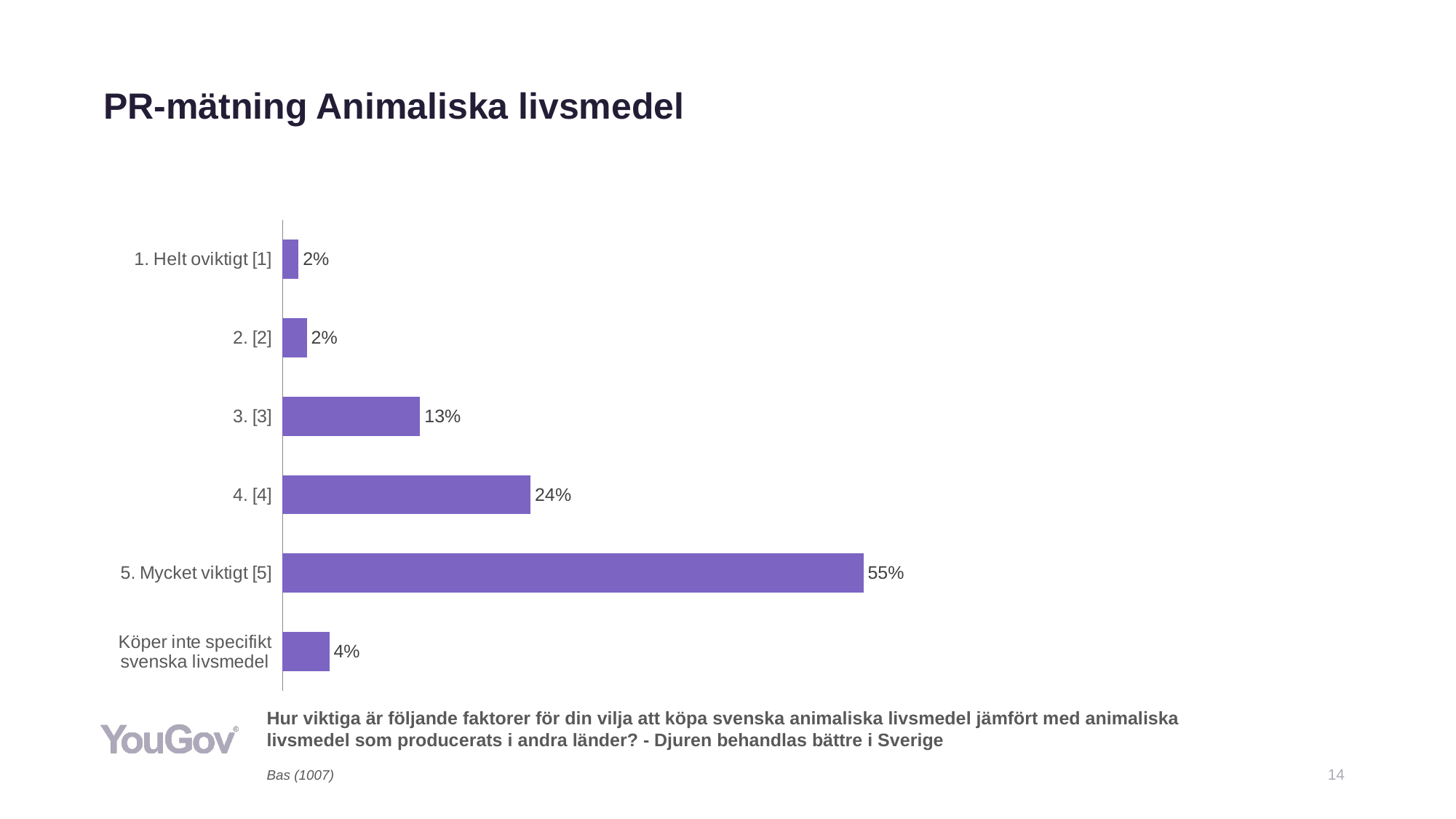
What percentage is shown for "3. [3]"? 13% What is the difference between the values for "3. [3]" and "Köper inte specifikt svenska livsmedel"? 9% What is the base (Bas) size stated below the chart? 1007 What kind of chart is shown on the slide? Bar chart What percentage is shown for "5. Mycket viktigt [5]"? 55% What is the difference between the values for "5. Mycket viktigt [5]" and "4. [4]"? 31% How many categories are shown in the chart? 6 Which is larger, the value for "3. [3]" or the value for "4. [4]"? 4. [4] What percentage is shown for "Köper inte specifikt svenska livsmedel"? 4% What percentage is shown for "4. [4]"? 24% Which category has the highest value? 5. Mycket viktigt [5] What is the combined value of "1. Helt oviktigt [1]" and "2. [2]"? 4%